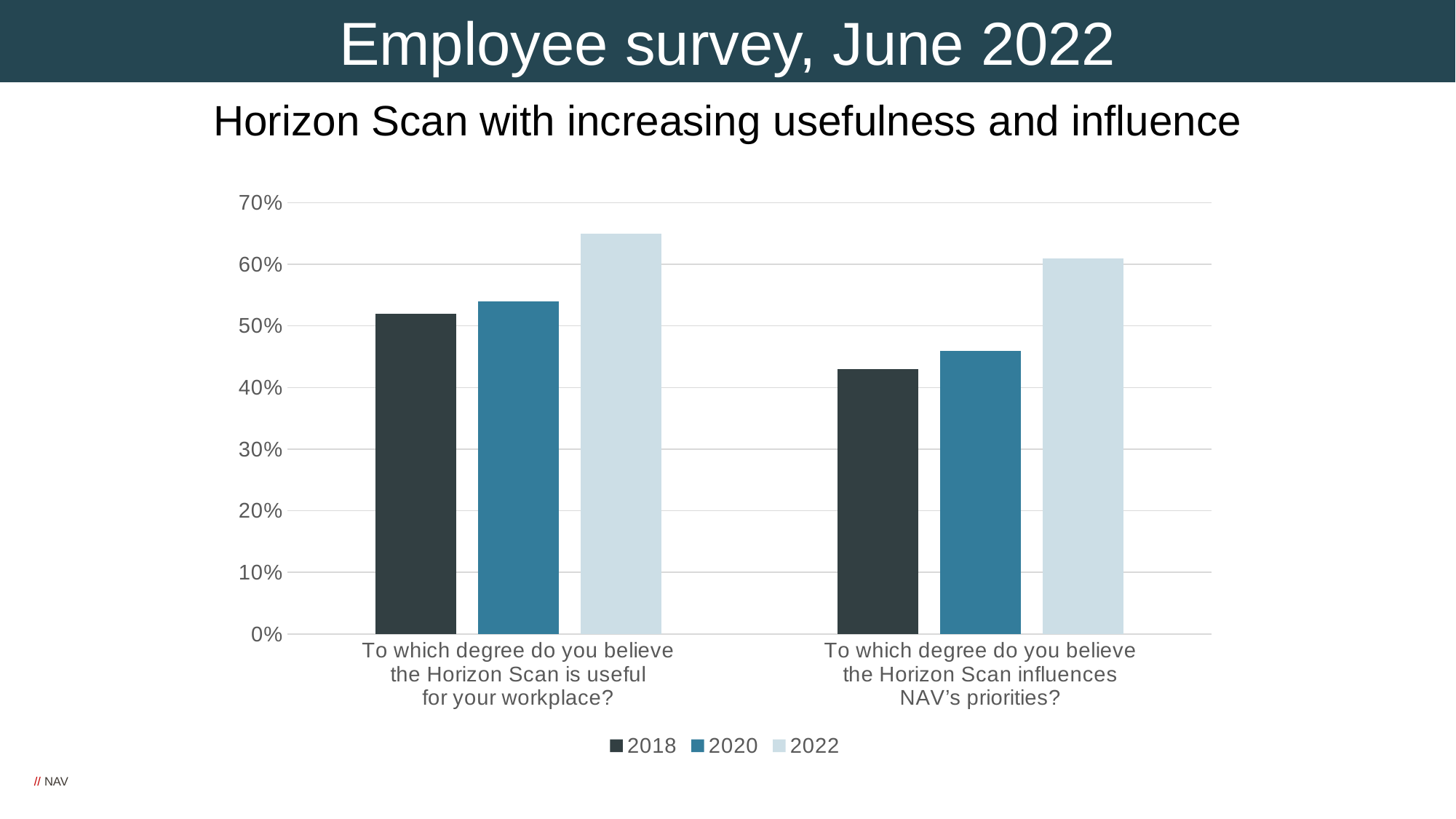
Is the 2018 value for "To which degree do you believe the Horizon Scan influences NAV's priorities?" greater or less than 50%? less How many question categories are shown on the x axis? 2 Which year has the lowest value for "To which degree do you believe the Horizon Scan influences NAV's priorities?"? 2018 How many series does the legend list? 3 Is the 2022 value for "To which degree do you believe the Horizon Scan is useful for your workplace?" greater or less than 60%? greater For "To which degree do you believe the Horizon Scan influences NAV's priorities?", which is larger: the 2022 value or the 2018 value? 2022 What kind of chart is shown on the slide? bar chart Is the 2020 value for "To which degree do you believe the Horizon Scan influences NAV's priorities?" greater or less than 40%? greater Which year has the highest value for "To which degree do you believe the Horizon Scan is useful for your workplace?"? 2022 Do the values for "To which degree do you believe the Horizon Scan is useful for your workplace?" rise or fall from 2018 to 2022? rise What is the title of the chart on the slide? Horizon Scan with increasing usefulness and influence